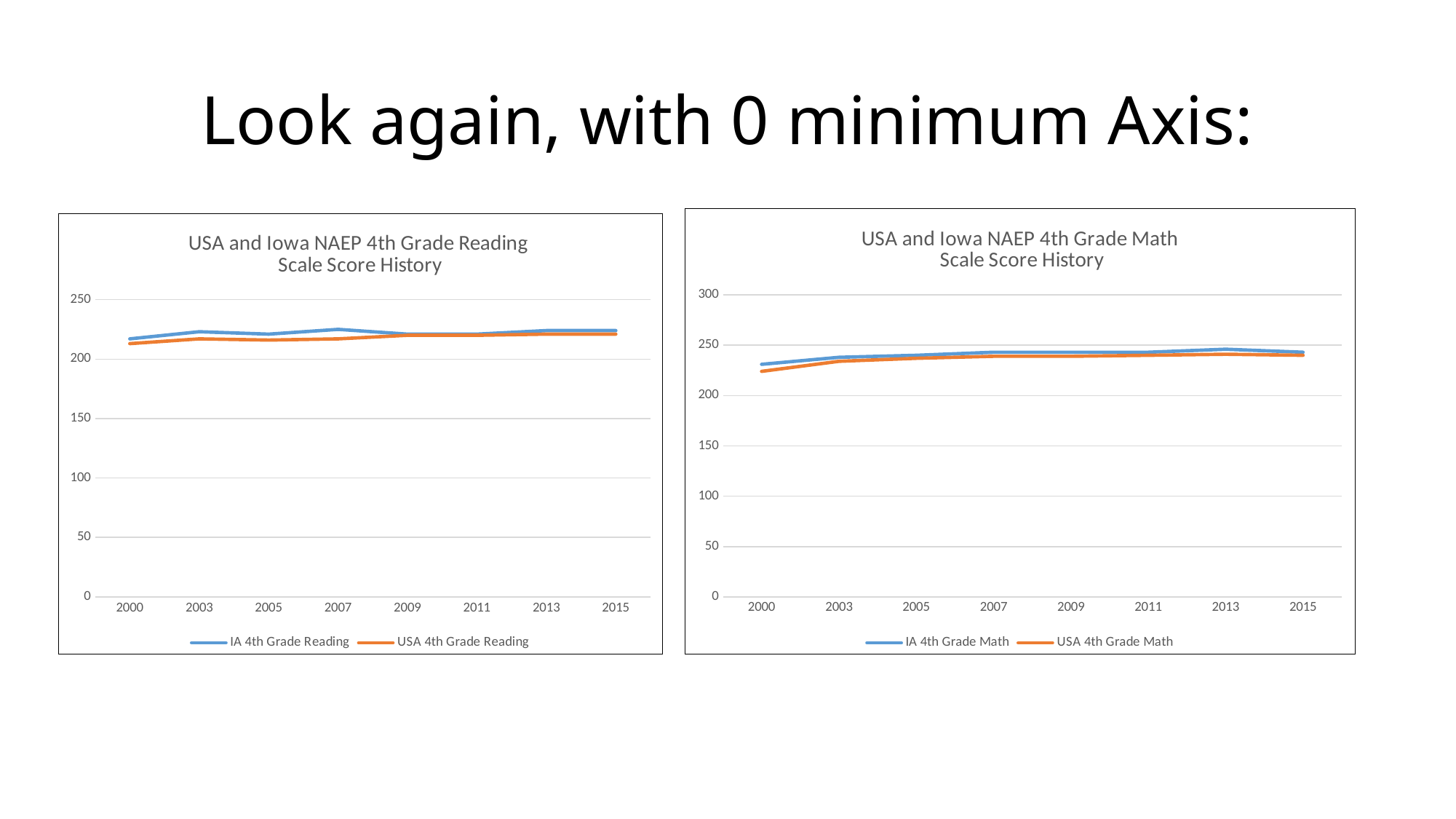
How many years are plotted along the x axis of the 'USA and Iowa NAEP 4th Grade Reading Scale Score History' chart? 8 How many series does the legend of the 'USA and Iowa NAEP 4th Grade Math Scale Score History' chart list? 2 In the 'USA and Iowa NAEP 4th Grade Reading Scale Score History' chart, is the value for IA 4th Grade Reading in 2000 greater or less than 200? greater What is the highest value shown on the y axis of the 'USA and Iowa NAEP 4th Grade Math Scale Score History' chart? 300 In the 'USA and Iowa NAEP 4th Grade Math Scale Score History' chart, does the USA 4th Grade Math line rise or fall from 2000 to 2015? rise What is the first year shown on the x axis of the 'USA and Iowa NAEP 4th Grade Math Scale Score History' chart? 2000 In the 'USA and Iowa NAEP 4th Grade Math Scale Score History' chart, is the value for USA 4th Grade Math in 2000 greater or less than 200? greater In the 'USA and Iowa NAEP 4th Grade Math Scale Score History' chart, which series has the higher value in 2000, IA 4th Grade Math or USA 4th Grade Math? IA 4th Grade Math In the 'USA and Iowa NAEP 4th Grade Reading Scale Score History' chart, what colour is the USA 4th Grade Reading line? orange In the 'USA and Iowa NAEP 4th Grade Reading Scale Score History' chart, is the value for USA 4th Grade Reading in 2015 greater or less than 250? less What kind of chart is the 'USA and Iowa NAEP 4th Grade Reading Scale Score History' chart? line chart